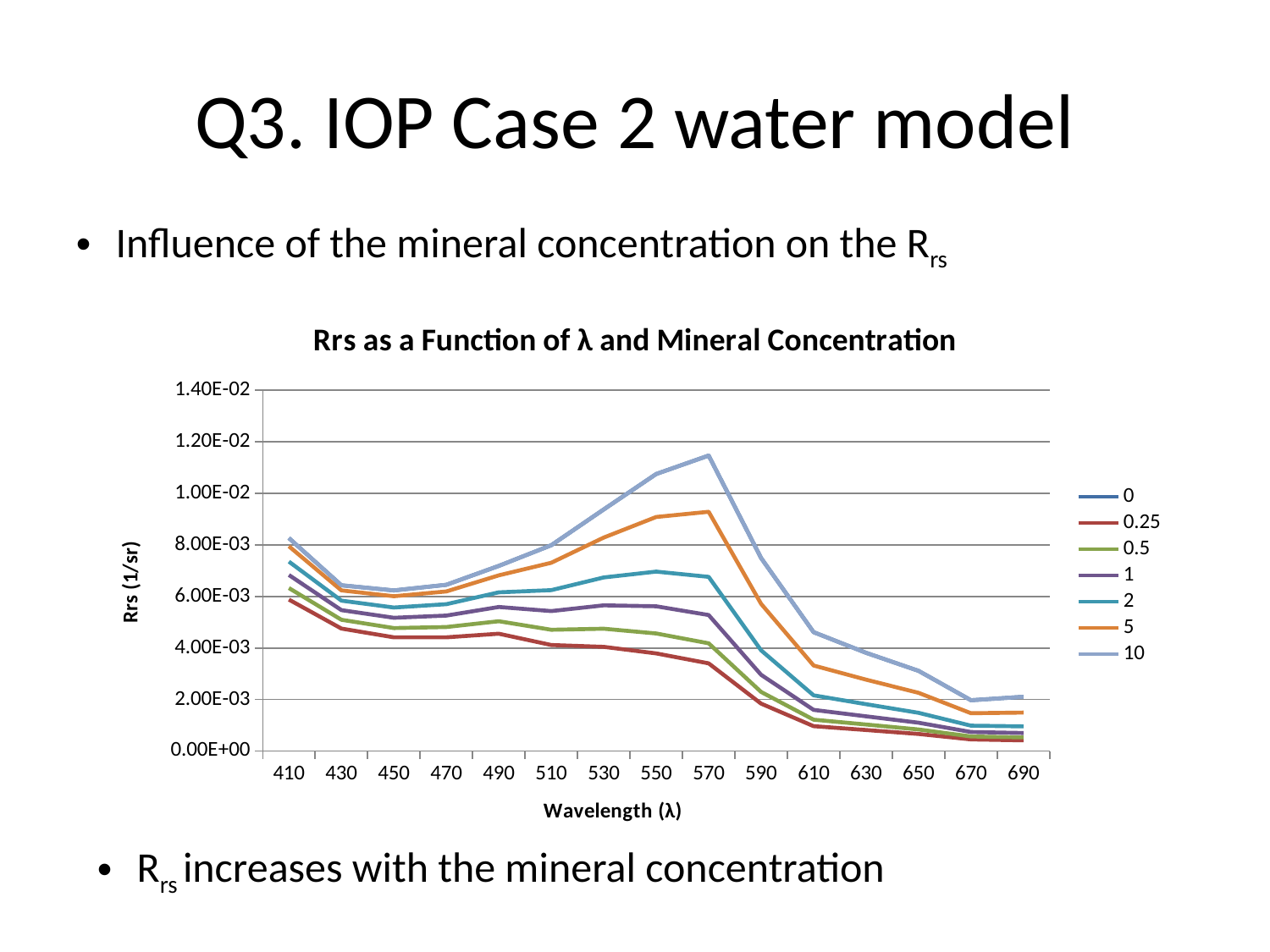
What kind of chart is shown on the slide? line chart Do the values of series 10 rise or fall from wavelength 570 to 690? fall At wavelength 550, which series has the larger value, 10 or 2? 10 What is the label of the y axis? Rrs (1/sr) Is the value of series 0.25 at wavelength 690 greater or less than 2.00E-03? less How many series does the legend list? 7 What is the title of the chart? Rrs as a Function of λ and Mineral Concentration At which wavelength does the series 10 reach its highest value? 570 How many wavelength points are plotted along the x axis? 15 Is the value of series 5 at wavelength 570 greater or less than 8.00E-03? greater Is the value of series 10 at wavelength 570 greater or less than 1.00E-02? greater